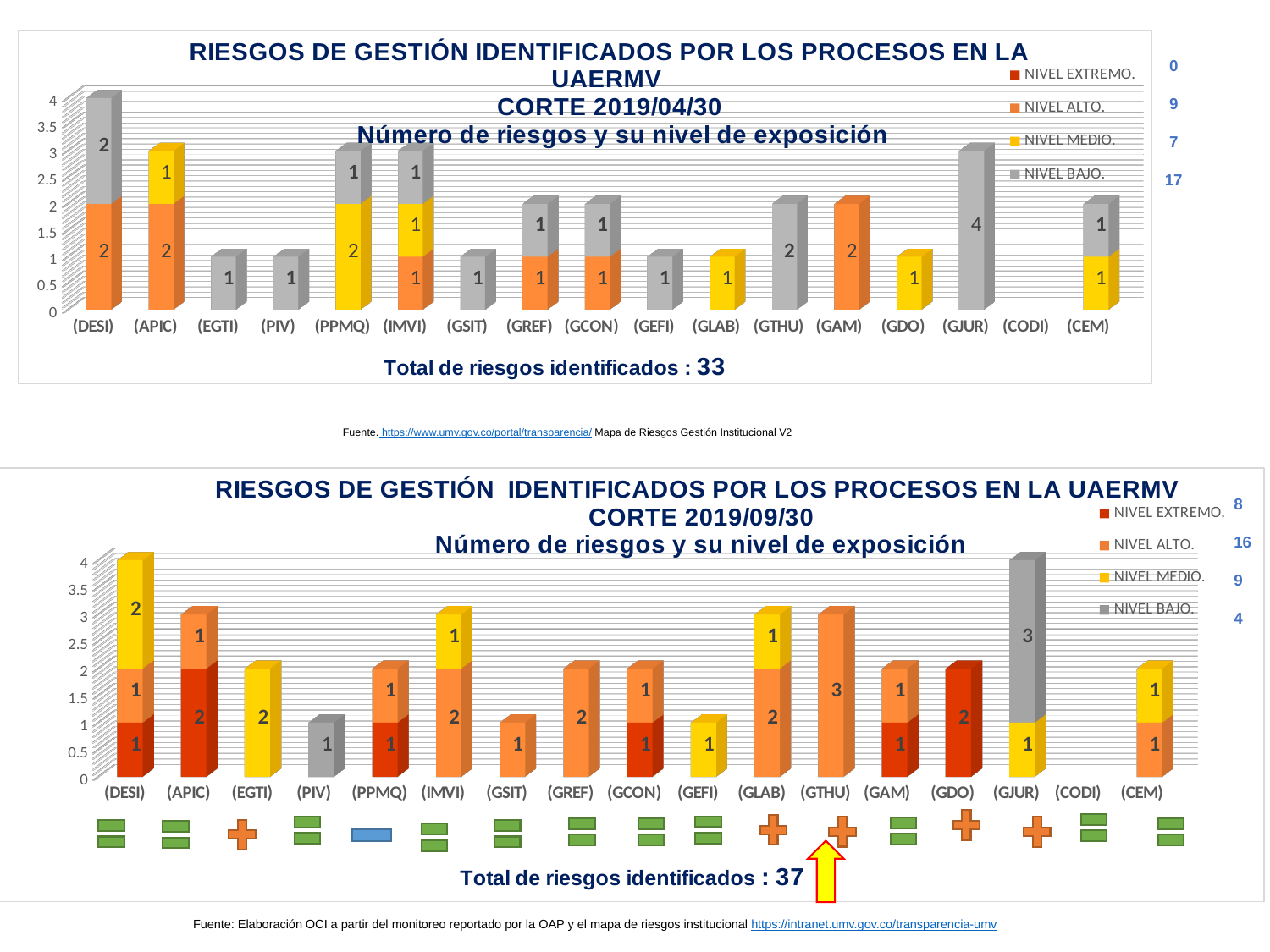
In the bottom chart (CORTE 2019/09/30), what is the NIVEL BAJO value for (GJUR)? 3 In the top chart (CORTE 2019/04/30), how many series does the legend list? 4 In the top chart (CORTE 2019/04/30), what is the NIVEL ALTO value for (DESI)? 2 In the bottom chart (CORTE 2019/09/30), how many categories are shown on the x axis? 17 In the bottom chart (CORTE 2019/09/30), which is larger, the total stacked bar for (GTHU) or for (GAM)? (GTHU) In the bottom chart (CORTE 2019/09/30), what is the NIVEL ALTO value for (GTHU)? 3 In the bottom chart (CORTE 2019/09/30), what is the total height of the stacked bar for (DESI)? 4 In the top chart (CORTE 2019/04/30), what is the total height of the stacked bar for (IMVI)? 3 In the bottom chart (CORTE 2019/09/30), what is the difference between the NIVEL EXTREMO value for (GDO) and the NIVEL EXTREMO value for (DESI)? 1 What type of chart is the bottom chart (CORTE 2019/09/30)? Stacked bar chart In the top chart (CORTE 2019/04/30), what is the NIVEL BAJO value for (GJUR)? 4 In the top chart (CORTE 2019/04/30), what is the total number of risks identified shown below the chart? 33